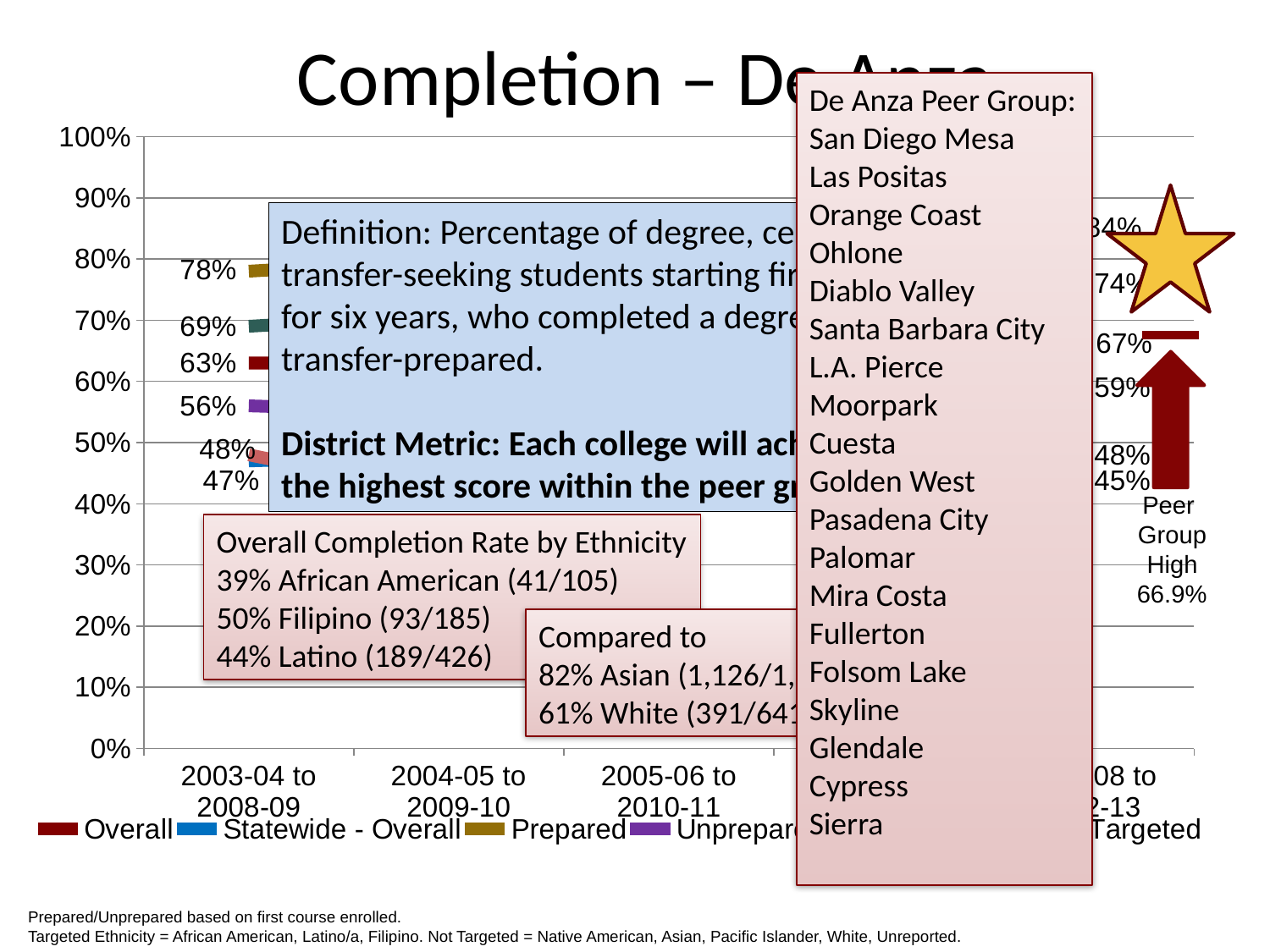
What is the Unprepared value for the 2003-04 to 2008-09 cohort? 56% For the 2003-04 to 2008-09 cohort, how many percentage points higher is Prepared than Unprepared? 22 percentage points What is the Prepared value for the 2003-04 to 2008-09 cohort? 78% Is the Overall value for the 2003-04 to 2008-09 cohort greater or less than 60%? greater Which series has the lowest labeled value for the 2003-04 to 2008-09 cohort? Statewide - Overall For the 2003-04 to 2008-09 cohort, which is larger: Prepared or Overall? Prepared What is the Statewide - Overall value for the 2003-04 to 2008-09 cohort? 47% What Peer Group High value is annotated on the chart? 66.9% What is the Overall value for the 2003-04 to 2008-09 cohort? 63% Which series has the highest labeled value for the 2003-04 to 2008-09 cohort? Prepared What is the first cohort label on the x axis? 2003-04 to 2008-09